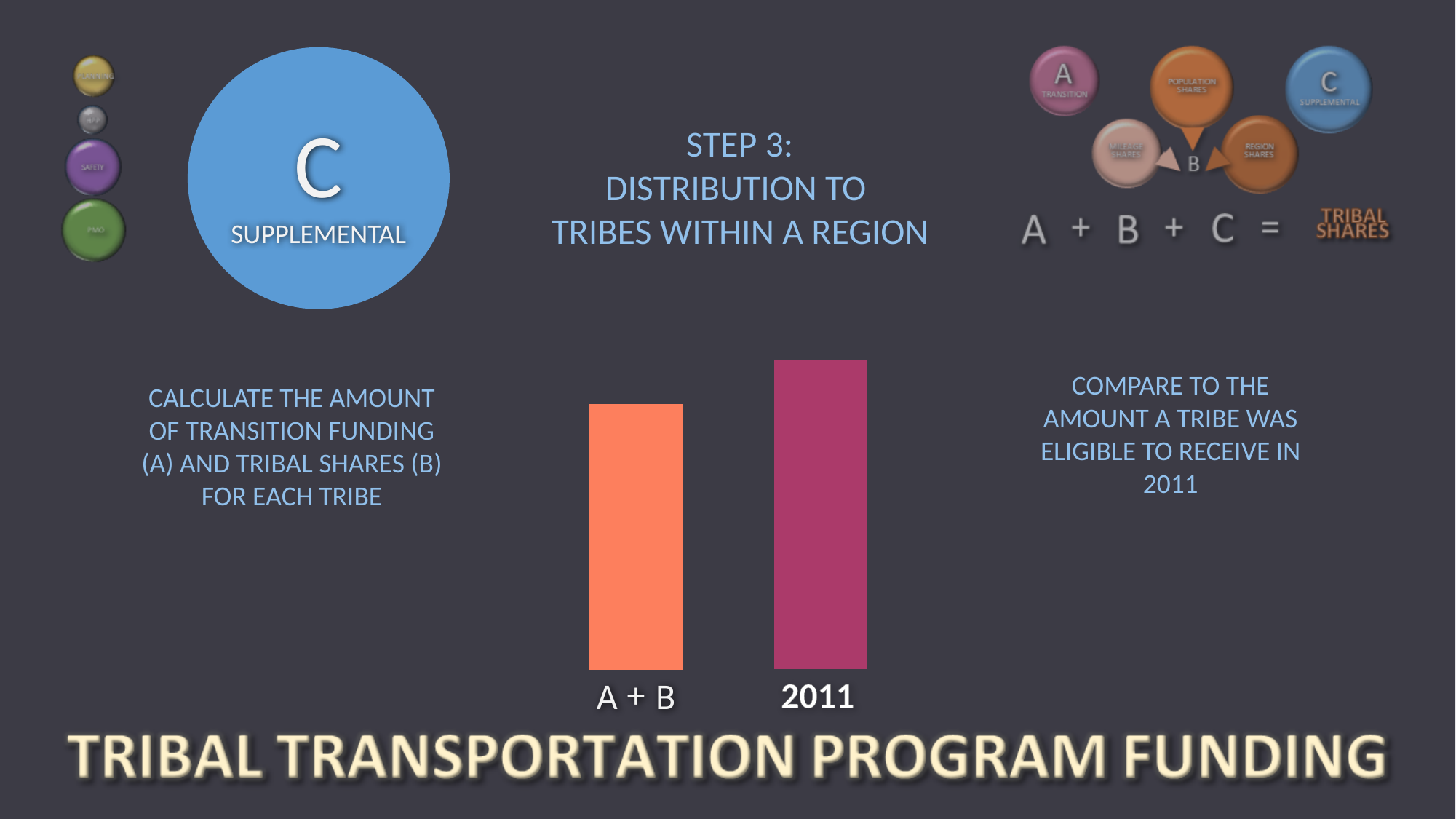
What kind of chart is shown in the middle of the slide? bar chart Which category has the highest bar? 2011 How many bars does the chart show? 2 Which bar is taller, A + B or 2011? 2011 What are the labels of the two bars in the chart? A + B and 2011 What colour is the A + B bar? orange Which category has the lowest bar? A + B